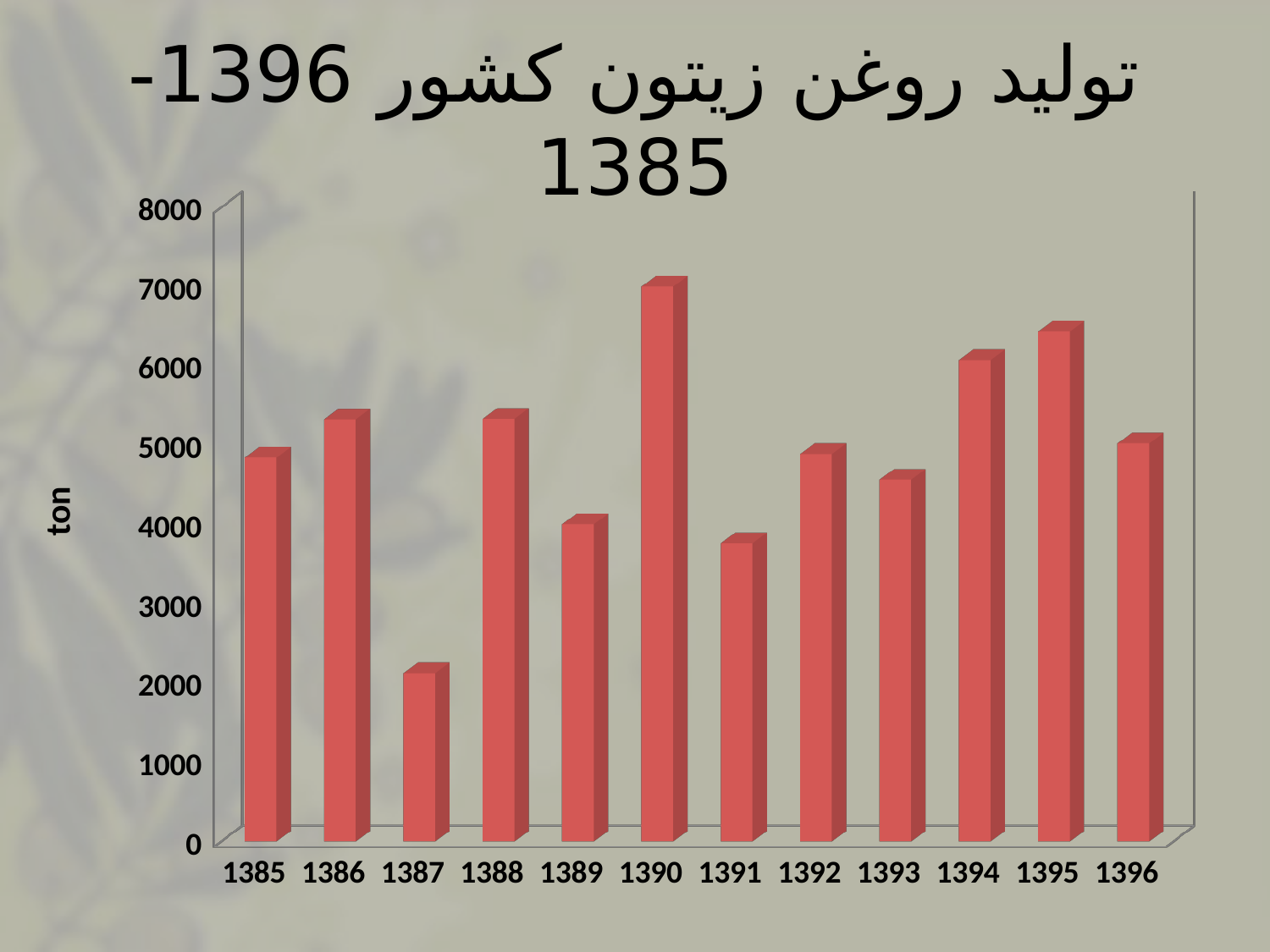
Is the value for 1390 greater or less than 6000? greater Is the value for 1387 greater or less than 3000? less What unit is shown on the vertical axis label of the chart? ton What kind of chart is shown on the slide? bar chart Is the value for 1393 greater or less than 5000? less Which year has the lowest bar in the chart? 1387 How many years are shown on the x axis of the chart? 12 Which year has the larger value, 1395 or 1394? 1395 Does the value rise or fall from 1386 to 1387? fall Which year has the highest bar in the chart? 1390 Which year has the larger value, 1391 or 1393? 1393